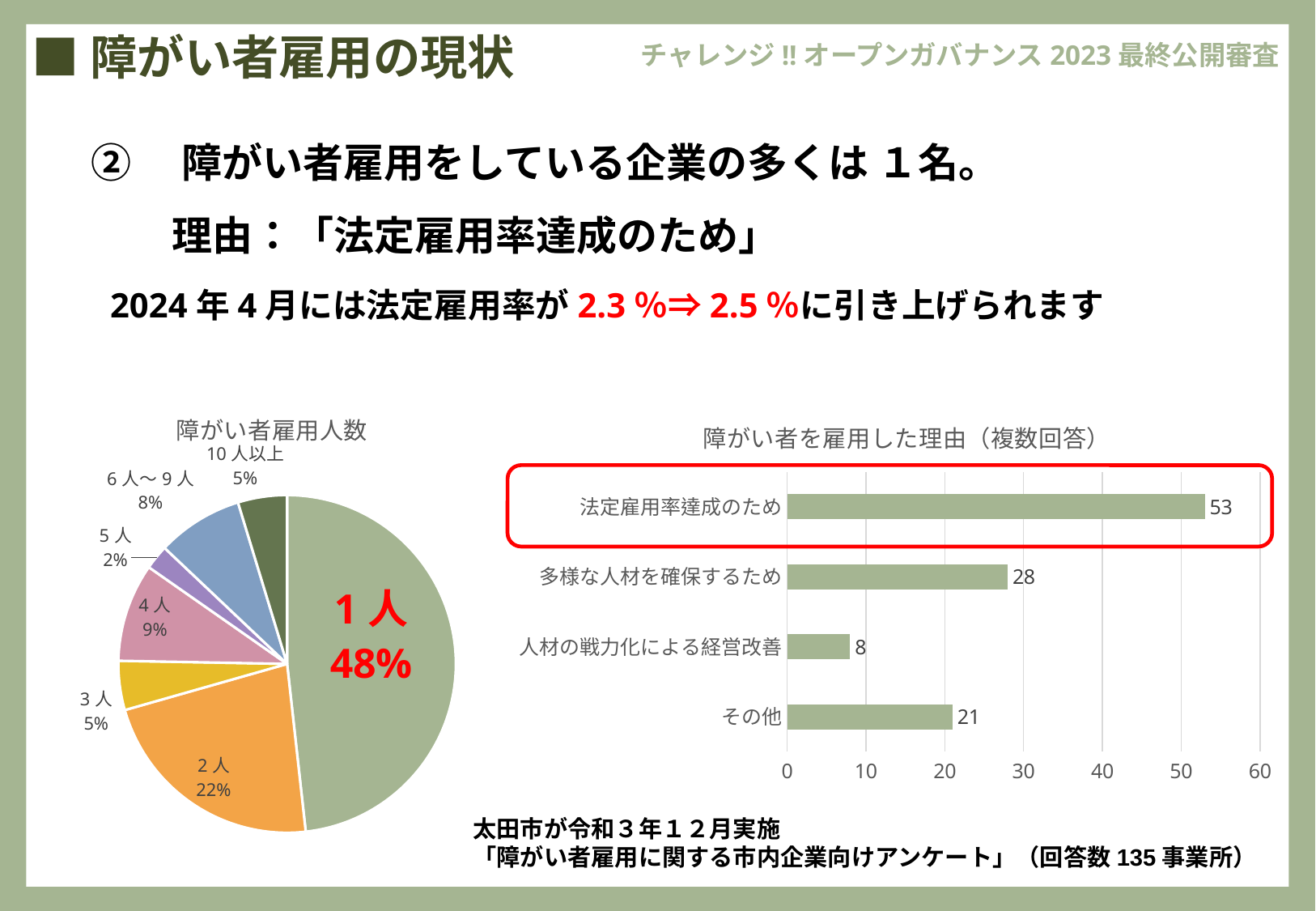
In the bar chart titled 障がい者を雇用した理由（複数回答）, how many categories are shown? 4 In the pie chart titled 障がい者雇用人数, which category has the smallest share? 5人 What is the title of the pie chart on the left side of the slide? 障がい者雇用人数 In the pie chart titled 障がい者雇用人数, what share is shown for 2人? 22% In the bar chart titled 障がい者を雇用した理由（複数回答）, what is the difference between 法定雇用率達成のため and 多様な人材を確保するため? 25 In the pie chart titled 障がい者雇用人数, how many slices are there? 7 In the bar chart titled 障がい者を雇用した理由（複数回答）, which category has the lowest value? 人材の戦力化による経営改善 In the pie chart titled 障がい者雇用人数, what share is shown for 1人? 48% In the bar chart titled 障がい者を雇用した理由（複数回答）, what is the value for 法定雇用率達成のため? 53 In the pie chart titled 障がい者雇用人数, which is larger, the share for 4人 or the share for 6人〜9人? 4人 In the bar chart titled 障がい者を雇用した理由（複数回答）, what is the value for その他? 21 What kind of chart is the chart on the right side of the slide, titled 障がい者を雇用した理由（複数回答）? bar chart